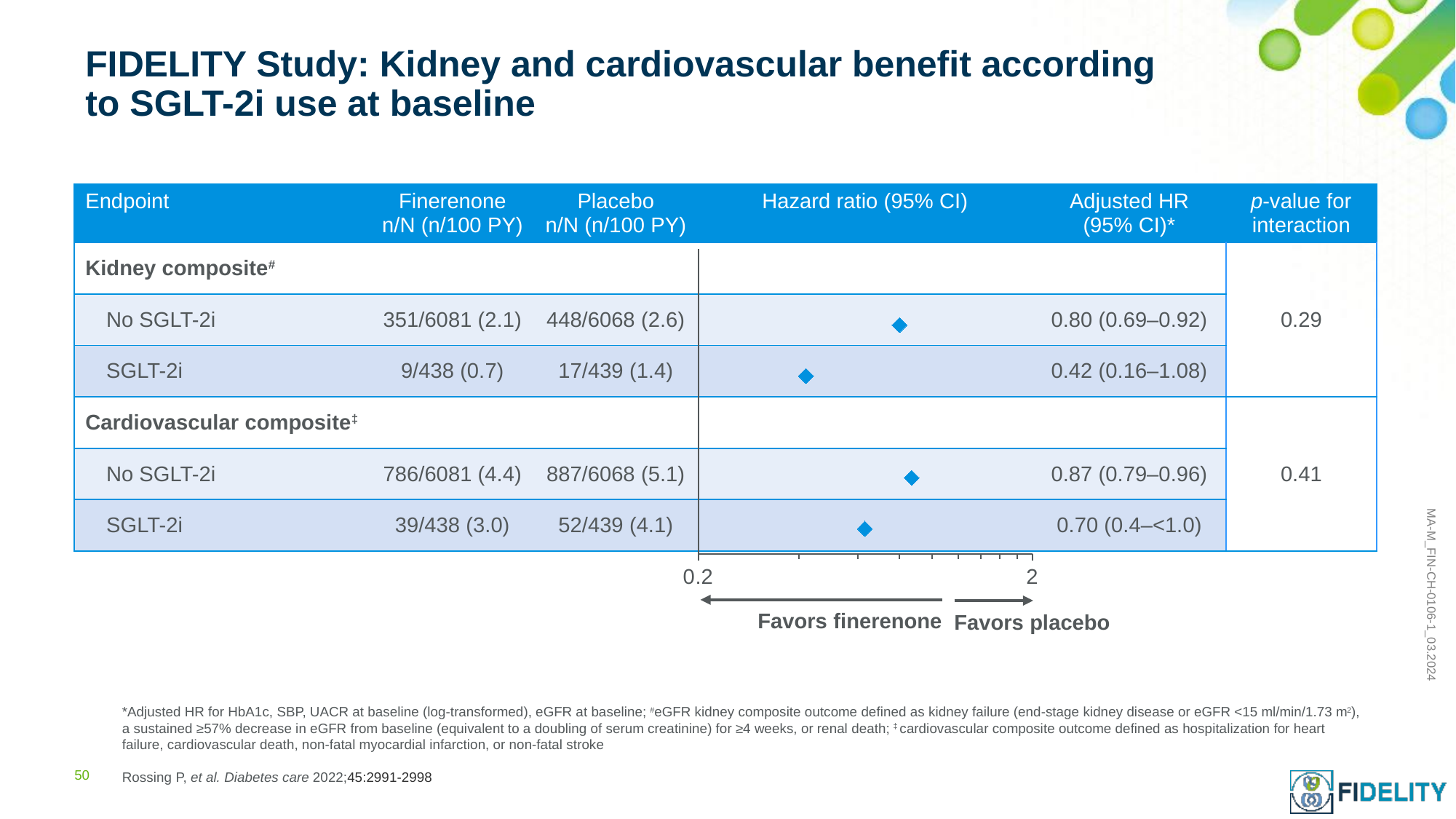
For the kidney composite endpoint, which subgroup has the larger adjusted hazard ratio: No SGLT-2i or SGLT-2i? No SGLT-2i Which subgroup has the lowest adjusted hazard ratio in the forest plot? Kidney composite, SGLT-2i What are the lowest and highest tick values shown on the hazard ratio axis? 0.2 and 2 What is the p-value for interaction for the kidney composite endpoint? 0.29 What is the difference between the adjusted HR point estimates for the No SGLT-2i subgroup in the cardiovascular composite and the kidney composite? 0.07 How many hazard ratio points are plotted in the forest plot? 4 What is the adjusted HR (95% CI) for the kidney composite endpoint in patients using SGLT-2i at baseline? 0.42 (0.16–1.08) What is the adjusted HR (95% CI) for the cardiovascular composite endpoint in patients using SGLT-2i? 0.70 (0.4–<1.0) What kind of chart is used to display the hazard ratios? Forest plot What is the adjusted HR (95% CI) for the kidney composite endpoint in patients with no SGLT-2i use at baseline? 0.80 (0.69–0.92) What is the adjusted HR (95% CI) for the cardiovascular composite endpoint in patients with no SGLT-2i use? 0.87 (0.79–0.96) Which subgroup has the highest adjusted hazard ratio in the forest plot? Cardiovascular composite, No SGLT-2i